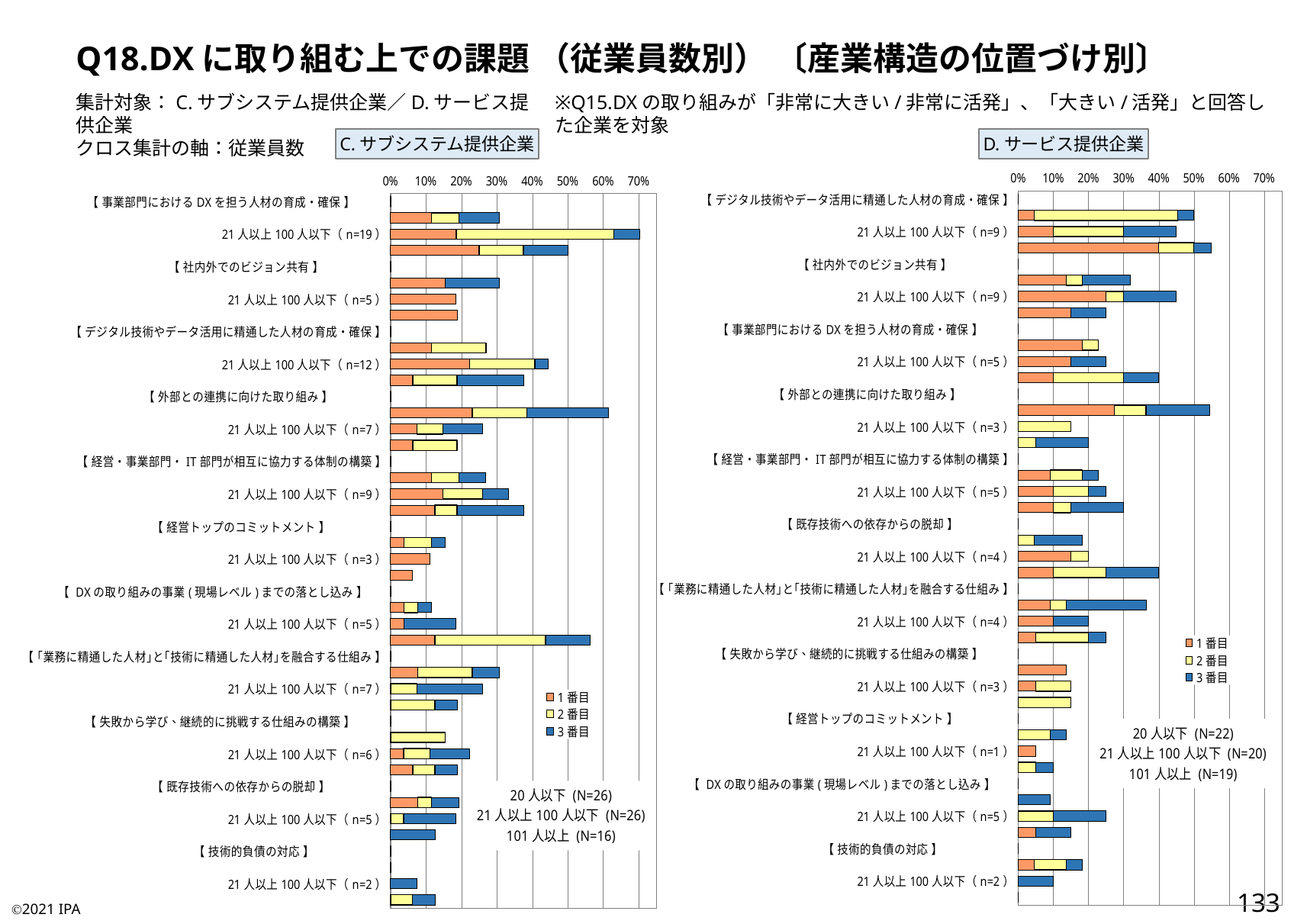
In the left chart (C. サブシステム提供企業), which bar is the longest overall? 21人以上100人以下 (n=19) under 事業部門におけるDXを担う人材の育成・確保 What is the maximum value shown on the horizontal axis of the right chart (D. サービス提供企業)? 70% In the left chart (C. サブシステム提供企業), is the total for the 21人以上100人以下 (n=19) bar under 事業部門におけるDXを担う人材の育成・確保 greater or less than 60%? greater How many series does the legend of the right chart (D. サービス提供企業) list? 3 What kind of chart is the left chart titled C. サブシステム提供企業? Stacked bar chart In the left chart (C. サブシステム提供企業), is the total for the 21人以上100人以下 (n=2) bar under 技術的負債の対応 greater or less than 10%? less In the left chart (C. サブシステム提供企業), what is the N for the 101人以上 group? 16 In the right chart (D. サービス提供企業), is the total for the 101人以上 bar under デジタル技術やデータ活用に精通した人材の育成・確保 greater or less than 50%? greater In the right chart (D. サービス提供企業), what is the N for the 20人以下 group? 22 What are the legend entries of the left chart (C. サブシステム提供企業)? 1番目, 2番目, 3番目